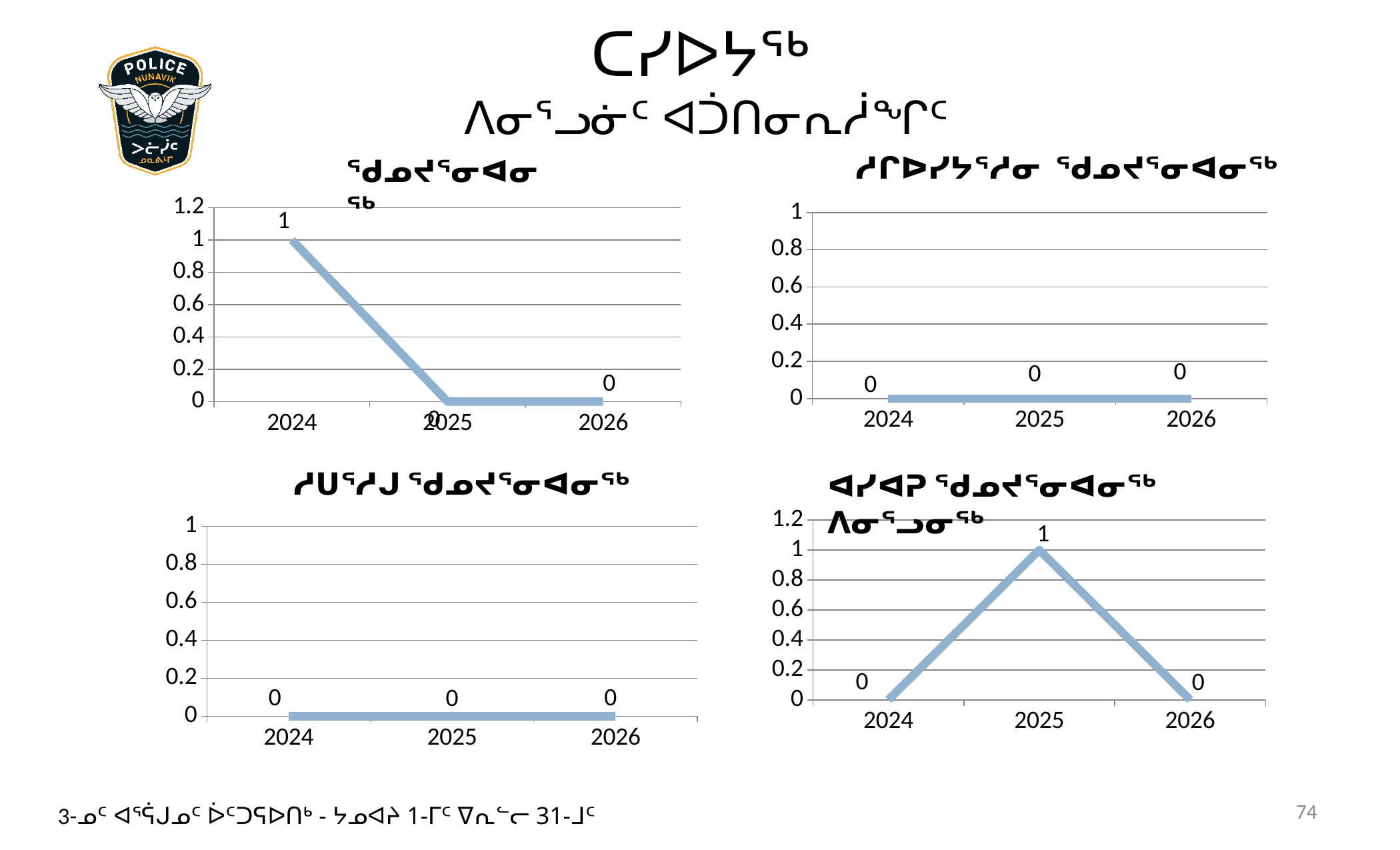
How many years are shown on the x axis of the bottom-left chart? 3 In the bottom-right chart, what is the value for 2025? 1 In the top-left chart, what is the value for 2024? 1 In the top-left chart, what is the difference between the values for 2024 and 2025? 1 In the bottom-right chart, which is larger, the value for 2025 or the value for 2026? 2025 In the top-left chart, does the value rise or fall from 2024 to 2025? fall In the top-left chart, which year has the highest value? 2024 In the top-left chart, what is the value for 2026? 0 In the bottom-right chart, which year has the highest value? 2025 What kind of chart is the top-left chart? line chart In the bottom-right chart, what is the value for 2024? 0 In the top-right chart, what is the value for 2025? 0